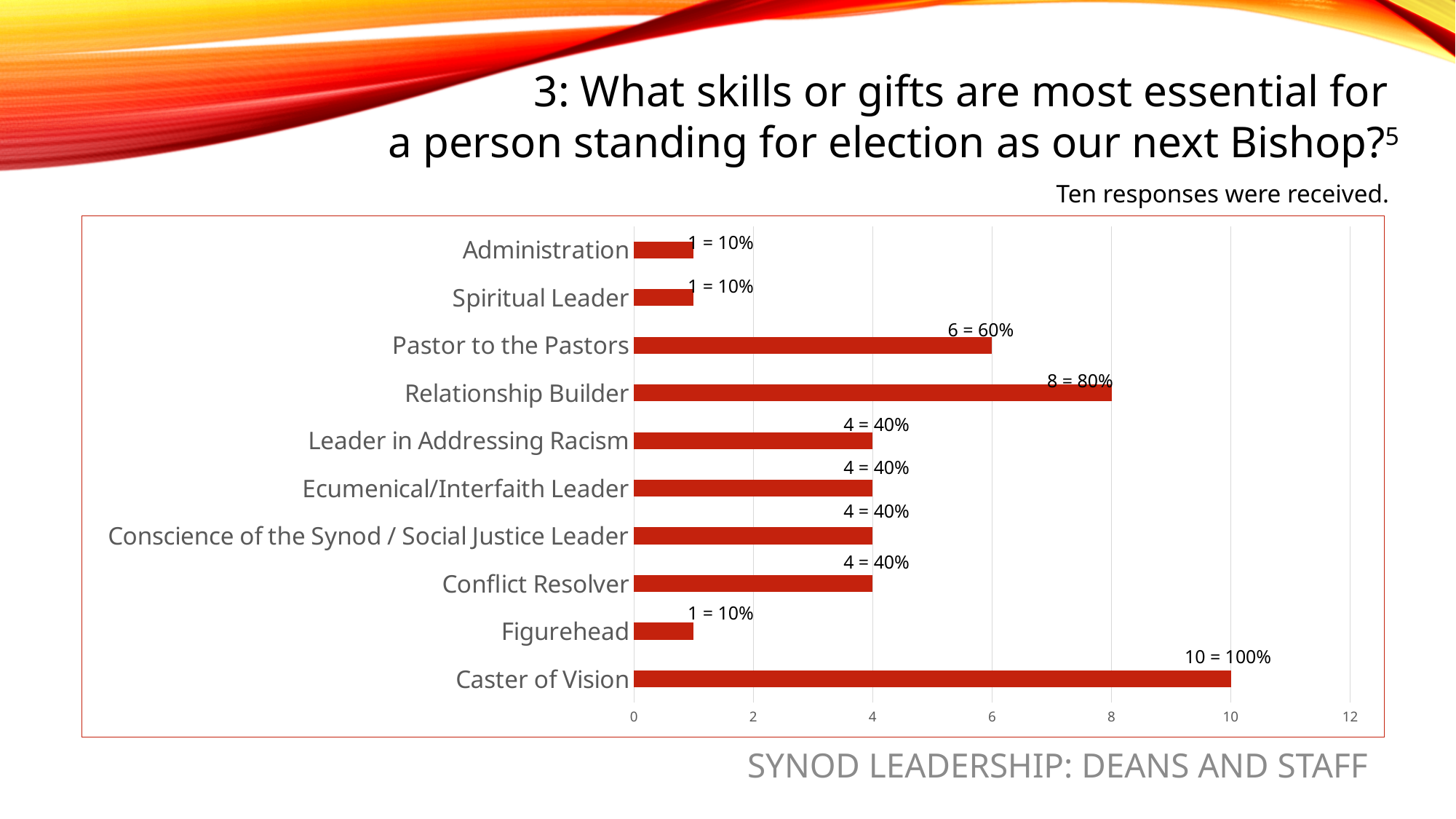
What is the data label for Pastor to the Pastors? 6 = 60% What kind of chart is shown on the slide? bar chart Is the value for Relationship Builder greater or less than 6? greater How many categories have a value of 4? 4 Which is larger, the value for Pastor to the Pastors or the value for Leader in Addressing Racism? Pastor to the Pastors What is the data label for Conflict Resolver? 4 = 40% What is the data label for Relationship Builder? 8 = 80% Which category has the highest value? Caster of Vision What is the difference between the values for Pastor to the Pastors and Figurehead? 5 How many categories are shown in the chart? 10 What is the difference between the values for Caster of Vision and Relationship Builder? 2 What is the maximum value shown on the x axis? 12